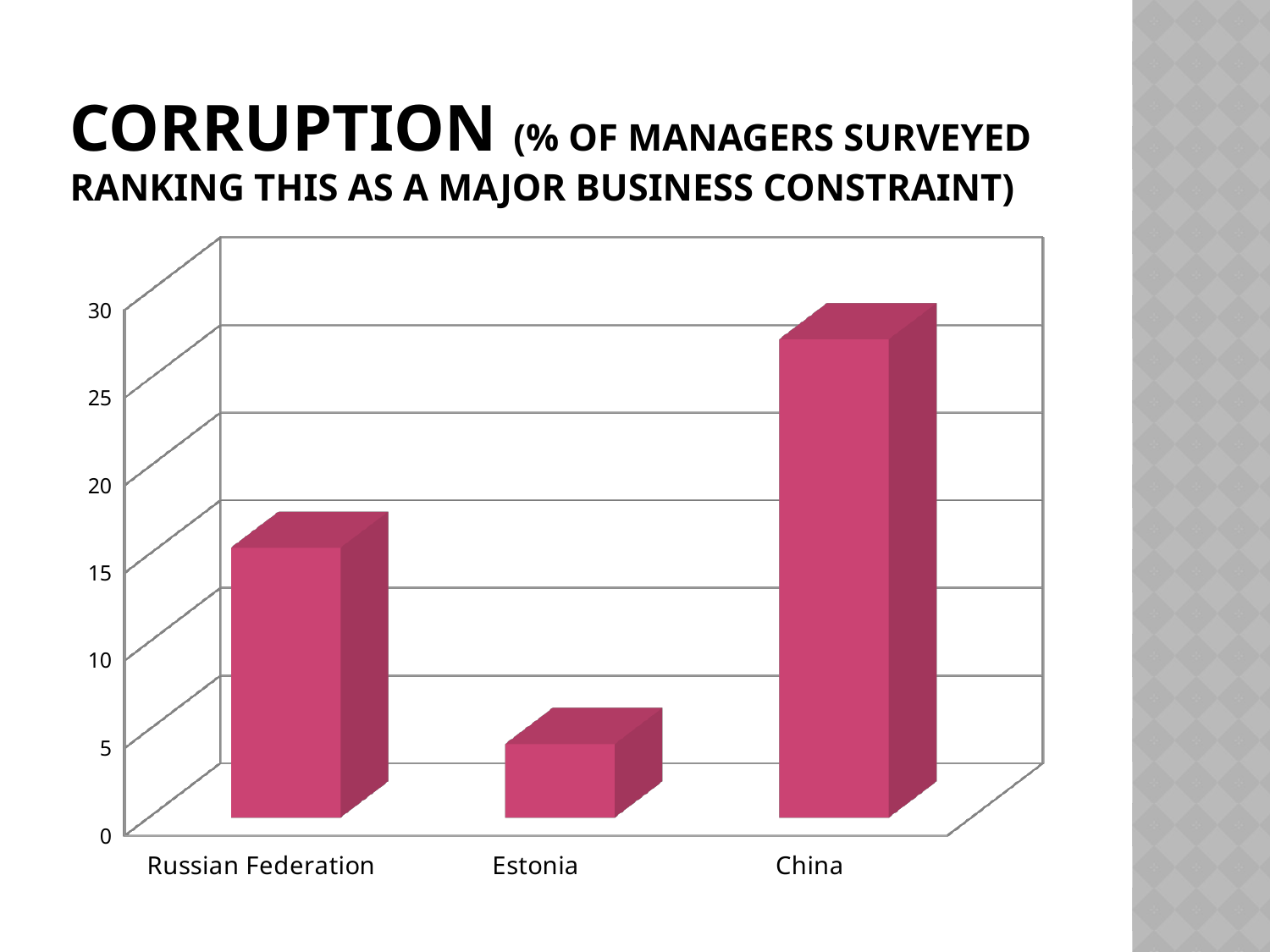
Which country has the lowest percentage of managers ranking corruption as a major business constraint? Estonia Is the value for China greater or less than 30? less Is the value for Estonia greater or less than 10? less Is the value for the Russian Federation greater or less than 10? greater Which country has the highest percentage of managers ranking corruption as a major business constraint? China What kind of chart is shown on the slide? bar chart Which has a higher value, China or the Russian Federation? China How many countries are shown on the chart? 3 Which has a higher value, the Russian Federation or Estonia? Russian Federation What is the title of the chart on the slide? Corruption (% of managers surveyed ranking this as a major business constraint)